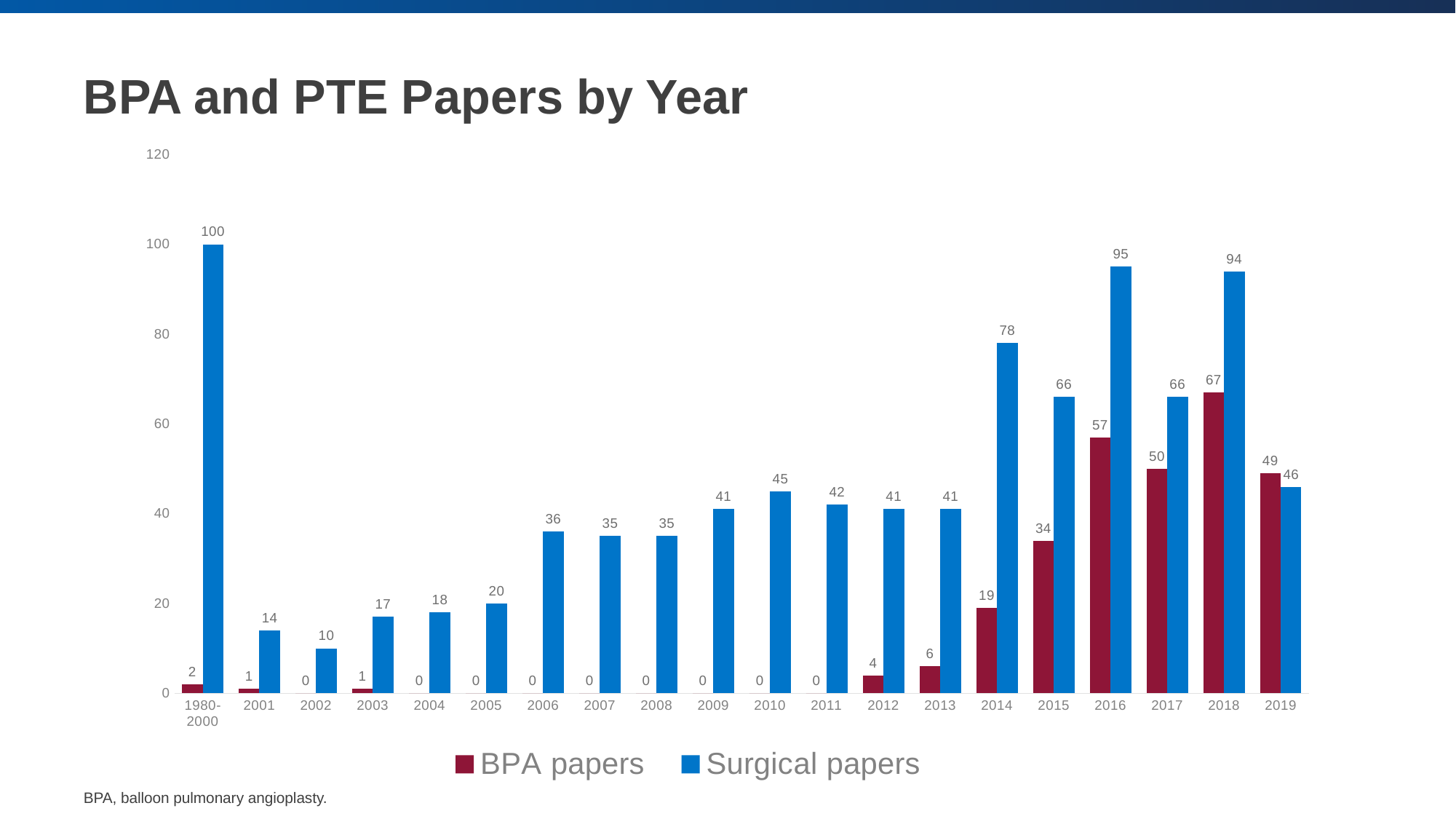
How many BPA papers were there in 2018? 67 How many Surgical papers were there in 2016? 95 Which year has the highest number of BPA papers? 2018 Is the value for Surgical papers in 2017 greater or less than 60? greater In 2019, which series has the larger value, BPA papers or Surgical papers? BPA papers Do BPA papers rise or fall from 2012 to 2018? Rise What kind of chart is shown on the slide? Bar chart How many series does the legend list? 2 How many categories are shown on the x axis? 20 What is the title of the chart? BPA and PTE Papers by Year What is the difference between Surgical papers and BPA papers in 2014? 59 Which category has the highest number of Surgical papers? 1980-2000